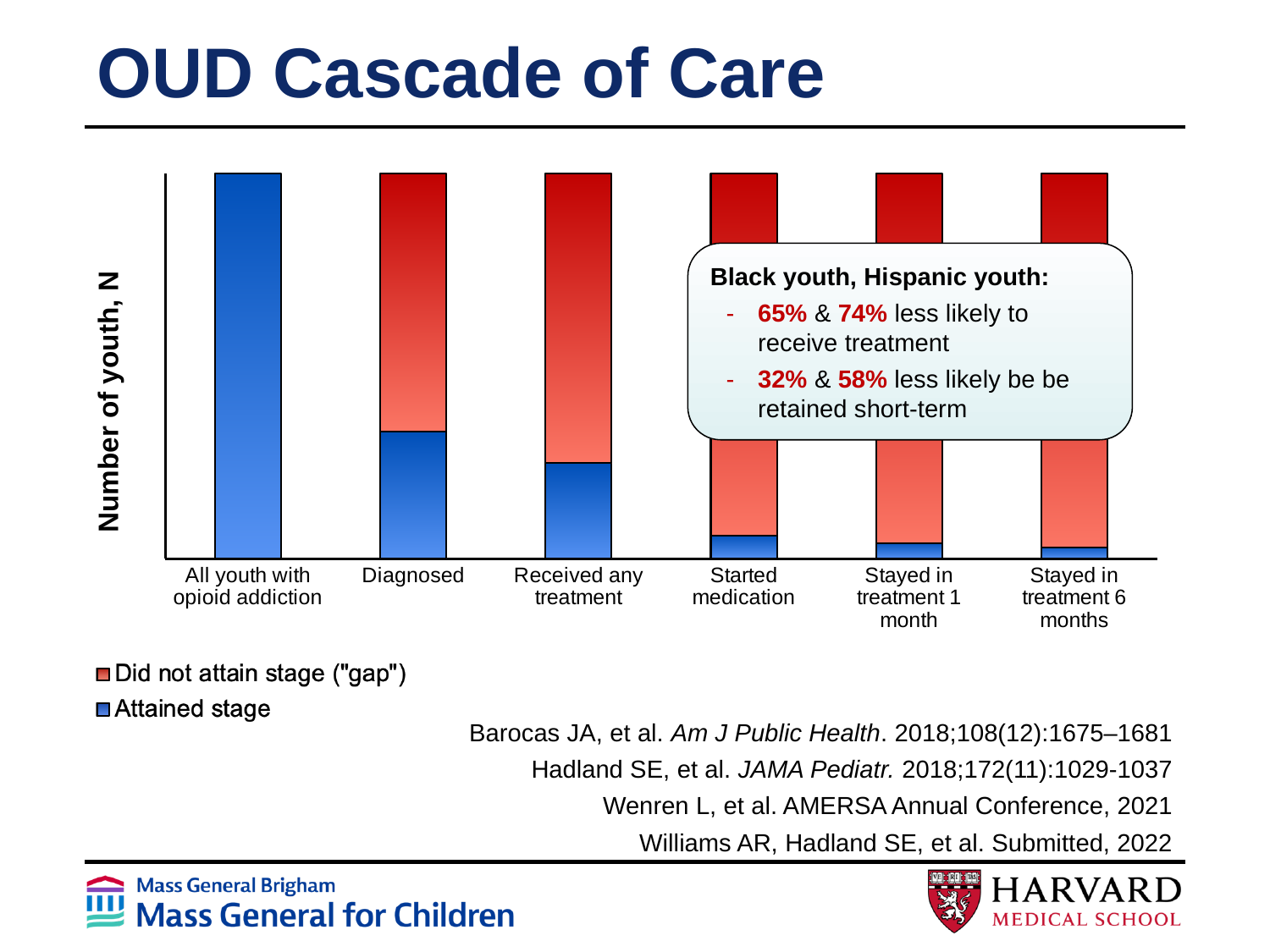
Which stage has the smallest 'Attained stage' portion? Stayed in treatment 6 months Which stage has the largest 'Attained stage' portion? All youth with opioid addiction Which stage has the larger 'Attained stage' portion, Diagnosed or Received any treatment? Diagnosed What is the label of the chart's y axis? Number of youth, N Does the 'Attained stage' portion rise or fall moving from left to right along the x axis? Fall How many series does the chart's legend list? 2 Does the 'Did not attain stage ("gap")' portion rise or fall moving from left to right along the x axis? Rise Which series is shown in blue in the chart? Attained stage How many stages (categories) are shown along the x axis of the chart? 6 What kind of chart is shown on the slide? Stacked bar chart Which stage has the larger 'Did not attain stage ("gap")' portion, Diagnosed or Started medication? Started medication